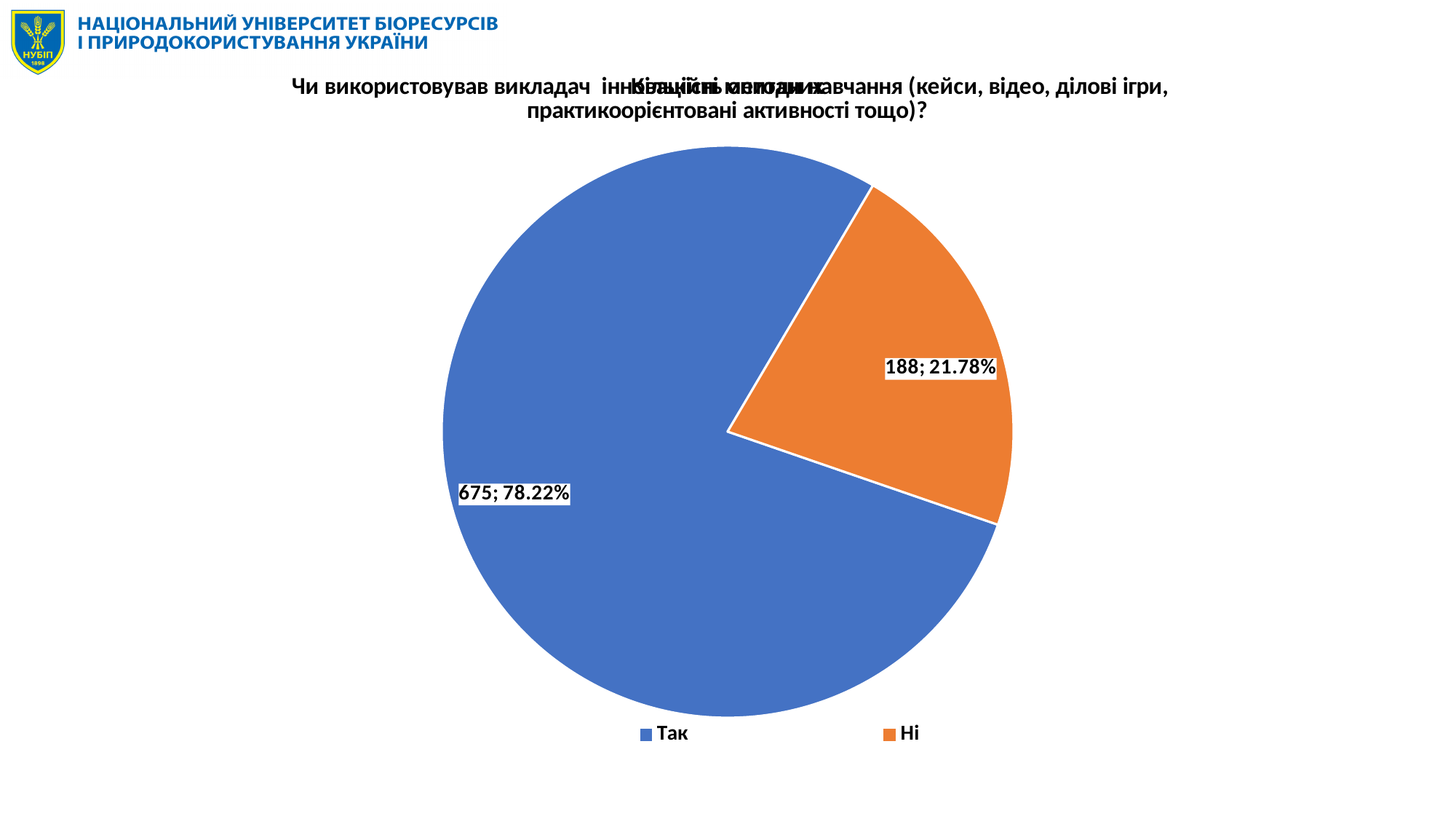
What is the count shown for the "Ні" slice? 188 Which slice is the largest? Так What percentage share does the "Так" slice have? 78.22% How many slices does the pie chart have? 2 What is the difference between the counts for "Так" and "Ні"? 487 What colour is the "Ні" slice? orange What percentage share does the "Ні" slice have? 21.78% Which slice is the smallest? Ні What is the count shown for the "Так" slice? 675 Which is larger, the count for "Так" or the count for "Ні"? Так How many entries does the legend list? 2 What kind of chart is shown on the slide? pie chart